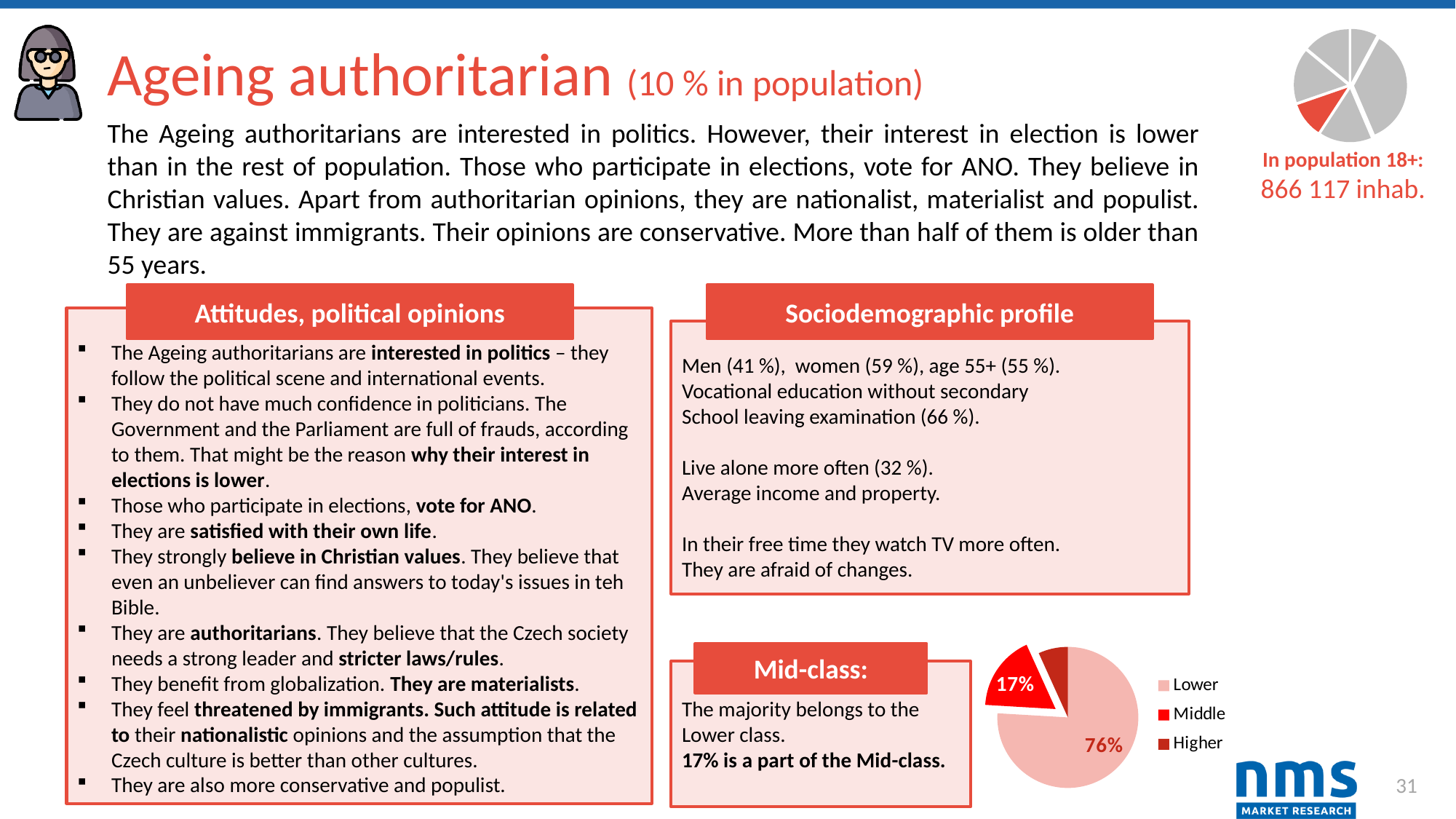
What kind of chart is shown in the Mid-class section at the bottom right of the slide? Pie chart In the Mid-class pie chart, what share is shown for the Lower class? 76% In the Mid-class pie chart, which class has the smallest slice? Higher In the Mid-class pie chart, how many percentage points larger is the Lower slice than the Middle slice? 59 percentage points In the Mid-class pie chart, which slice is larger: Lower or Middle? Lower According to the Mid-class pie chart, what share of the pie does the Middle class make up? 17% In the Mid-class pie chart, which class has the largest slice? Lower How many slices does the Mid-class pie chart have? 3 In the Mid-class pie chart, what colour is the Middle slice? Red In the Mid-class pie chart, what share is shown for the Middle class? 17% What are the legend entries of the Mid-class pie chart? Lower, Middle, Higher How many entries does the legend of the Mid-class pie chart list? 3